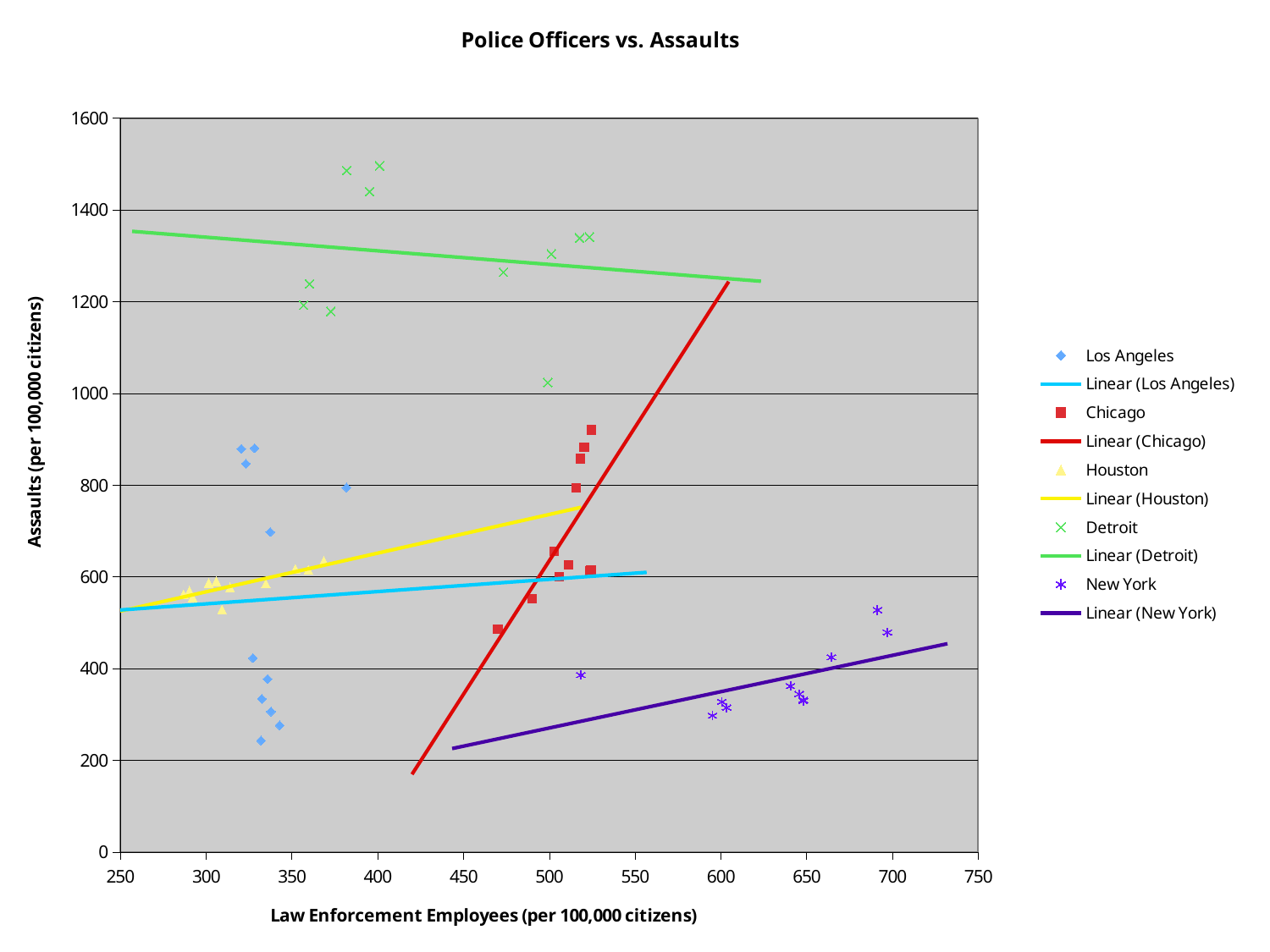
Which city has the highest law enforcement employee values (furthest right on the x axis)? New York What is the title of the chart? Police Officers vs. Assaults What kind of chart is shown on the slide? Scatter chart How many entries does the chart's legend list? 10 Does the Linear (Chicago) trend line rise or fall as law enforcement employees increase? rise Which city has the highest assault values in the chart? Detroit Which city has higher assault values, Detroit or New York? Detroit How many cities are plotted as data point series in the chart? 5 What is the label of the x axis? Law Enforcement Employees (per 100,000 citizens) Are the New York data points greater or less than 600 assaults per 100,000 citizens? less Does the Linear (Detroit) trend line rise or fall as law enforcement employees increase? fall Are the Detroit data points greater or less than 1000 assaults per 100,000 citizens? greater